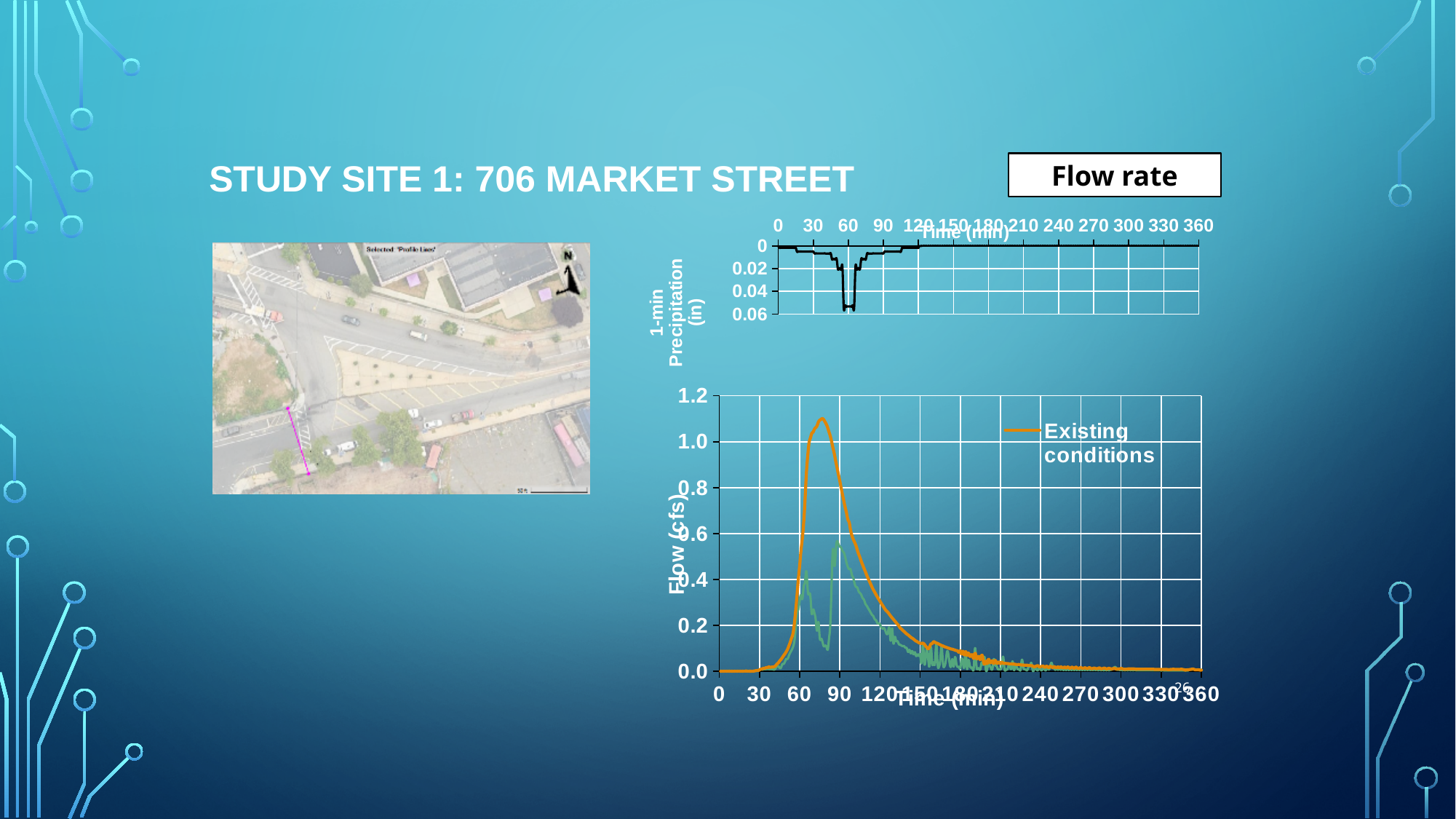
In the top precipitation chart, is the peak 1-min precipitation value greater or less than 0.04? greater In the bottom Flow rate chart, does the Existing conditions flow rise or fall between 90 and 240 minutes? fall In the bottom Flow rate chart, how many series does the legend list? 1 In the bottom Flow rate chart, at 90 minutes, which line has the higher flow, the orange Existing conditions line or the green line? orange Existing conditions line In the bottom Flow rate chart, is the peak value of the Existing conditions line greater or less than 1.0? greater What kind of chart is the bottom chart labelled Flow rate? line chart In the bottom Flow rate chart, what is the y-axis title? Flow (cfs) In the top precipitation chart, is the 1-min precipitation at 240 minutes greater or less than 0.02? less In the bottom Flow rate chart, what is the legend entry for the orange line? Existing conditions What kind of chart is the top chart showing 1-min Precipitation? line chart In the bottom Flow rate chart, what is the largest value shown on the Time (min) axis? 360